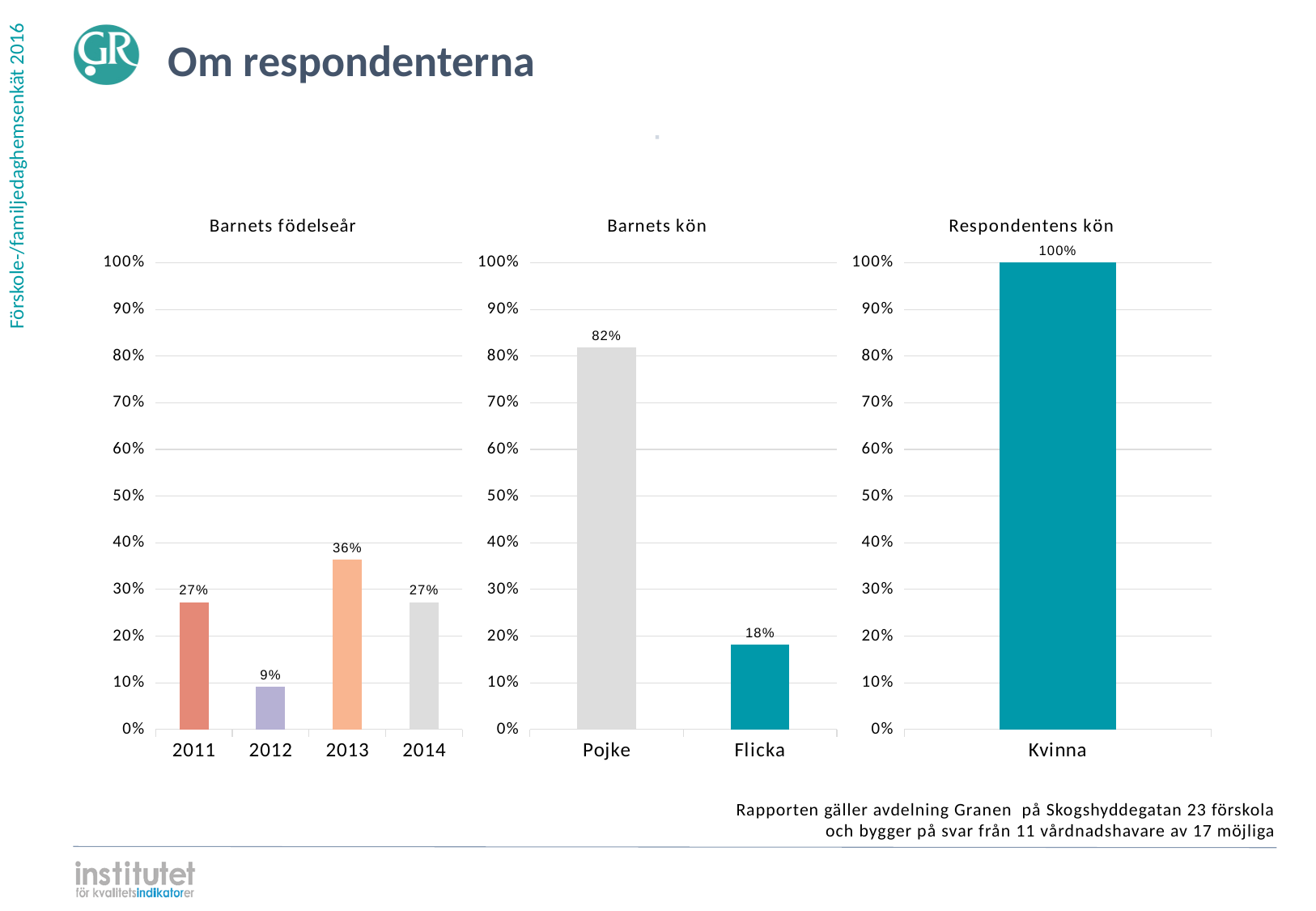
In the 'Barnets kön' chart, which category is larger, Pojke or Flicka? Pojke In the 'Barnets kön' chart, what is the value for Pojke? 82% What kind of chart is the 'Respondentens kön' chart? Bar chart In the 'Barnets födelseår' chart, what is the difference between the values for 2013 and 2012? 27% How many charts are shown on the slide? 3 In the 'Barnets kön' chart, what is the value for Flicka? 18% In the 'Barnets födelseår' chart, what is the value for 2013? 36% In the 'Barnets födelseår' chart, how many years are shown? 4 In the 'Barnets kön' chart, what is the difference between Pojke and Flicka? 64% In the 'Barnets födelseår' chart, which year has the lowest value? 2012 In the 'Respondentens kön' chart, what is the value for Kvinna? 100% In the 'Barnets födelseår' chart, which year has the highest value? 2013